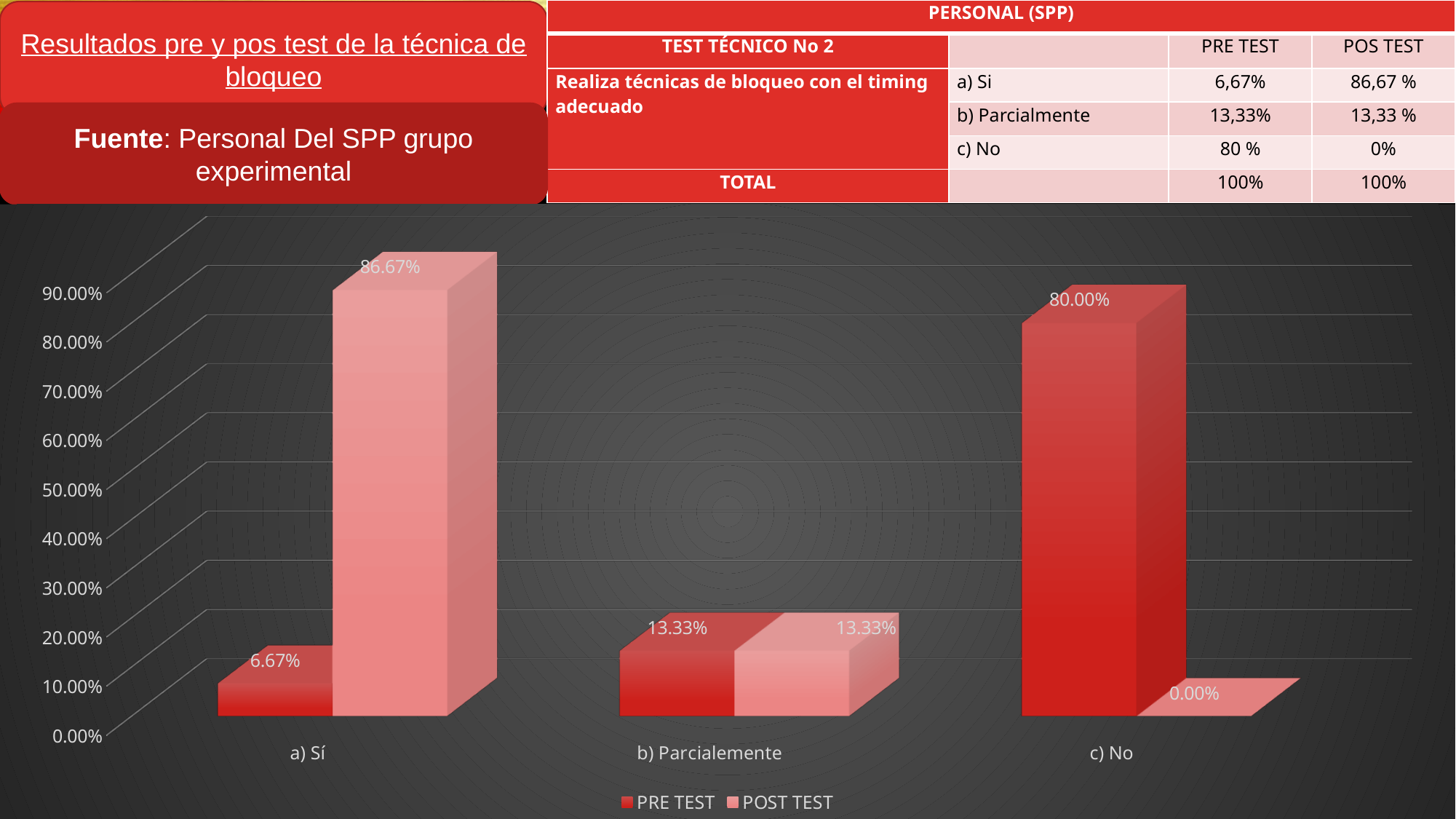
What is the POST TEST value for c) No? 0.00% What is the difference between the POST TEST and PRE TEST values for a) Sí? 80.00% What is the PRE TEST value for c) No? 80.00% Which category has the lowest POST TEST value? c) No What kind of chart is shown on the slide? bar chart How many categories are shown on the x axis? 3 What is the PRE TEST value for a) Sí? 6.67% What is the POST TEST value for a) Sí? 86.67% Which is larger for c) No, the PRE TEST value or the POST TEST value? PRE TEST How many series does the legend list? 2 What are the two series named in the legend? PRE TEST and POST TEST Which category has the highest PRE TEST value? c) No